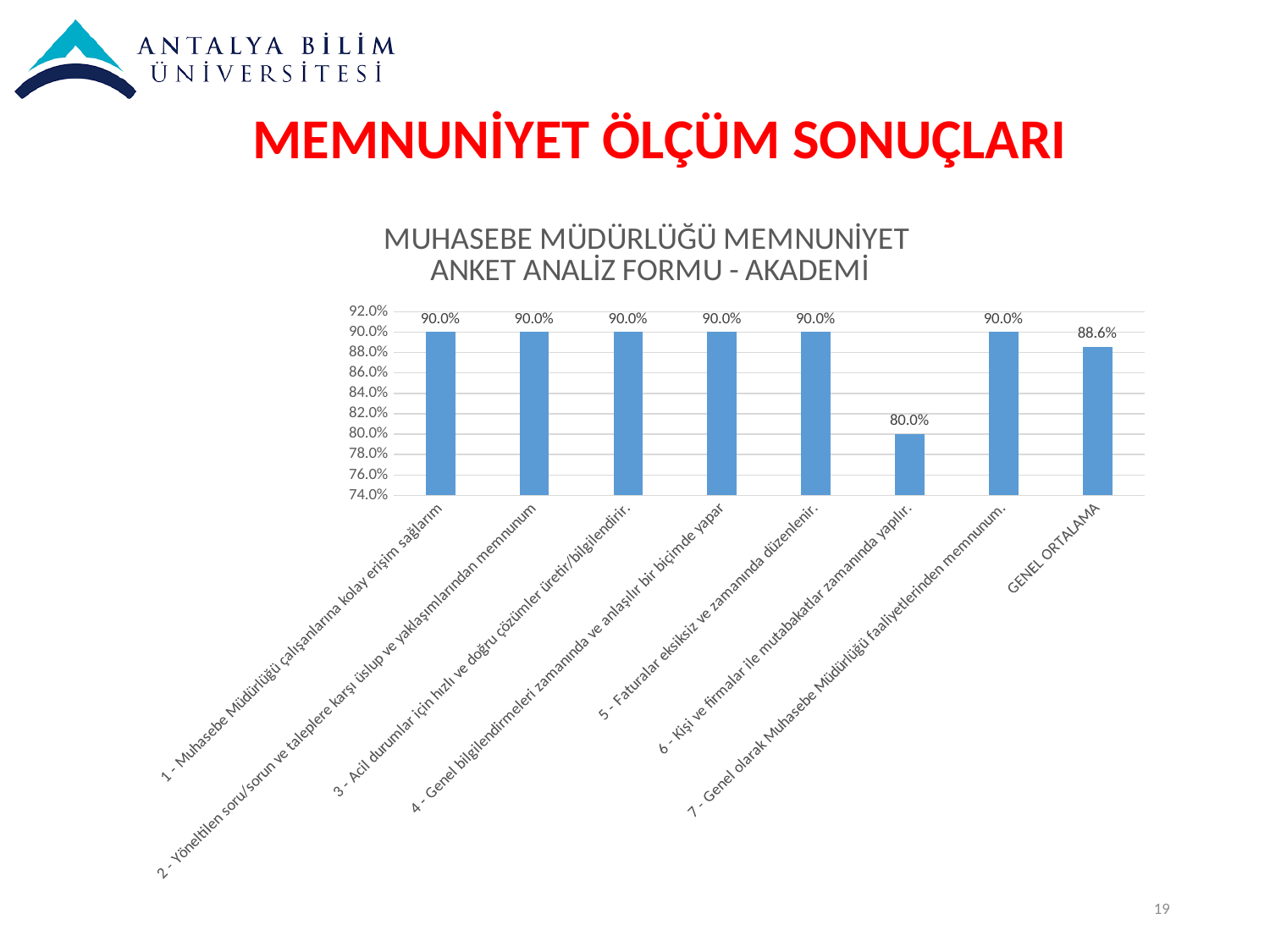
What is the value for GENEL ORTALAMA? 88.6% How many bars are plotted in the chart? 8 What is the value for '1 - Muhasebe Müdürlüğü çalışanlarına kolay erişim sağlarım'? 90.0% What is the difference between the value for '5 - Faturalar eksiksiz ve zamanında düzenlenir.' and GENEL ORTALAMA? 1.4% Which is larger, the value for GENEL ORTALAMA or the value for '6 - Kişi ve firmalar ile mutabakatlar zamanında yapılır.'? GENEL ORTALAMA Which category has the lowest value? 6 - Kişi ve firmalar ile mutabakatlar zamanında yapılır. Is the value for '6 - Kişi ve firmalar ile mutabakatlar zamanında yapılır.' greater or less than 84.0%? less What is the difference between the value for '7 - Genel olarak Muhasebe Müdürlüğü faaliyetlerinden memnunum.' and the value for '6 - Kişi ve firmalar ile mutabakatlar zamanında yapılır.'? 10.0% What is the chart's title? MUHASEBE MÜDÜRLÜĞÜ MEMNUNİYET ANKET ANALİZ FORMU - AKADEMİ How many categories have a value of 90.0%? 6 What is the value for '6 - Kişi ve firmalar ile mutabakatlar zamanında yapılır.'? 80.0% What type of chart is shown on the slide? bar chart